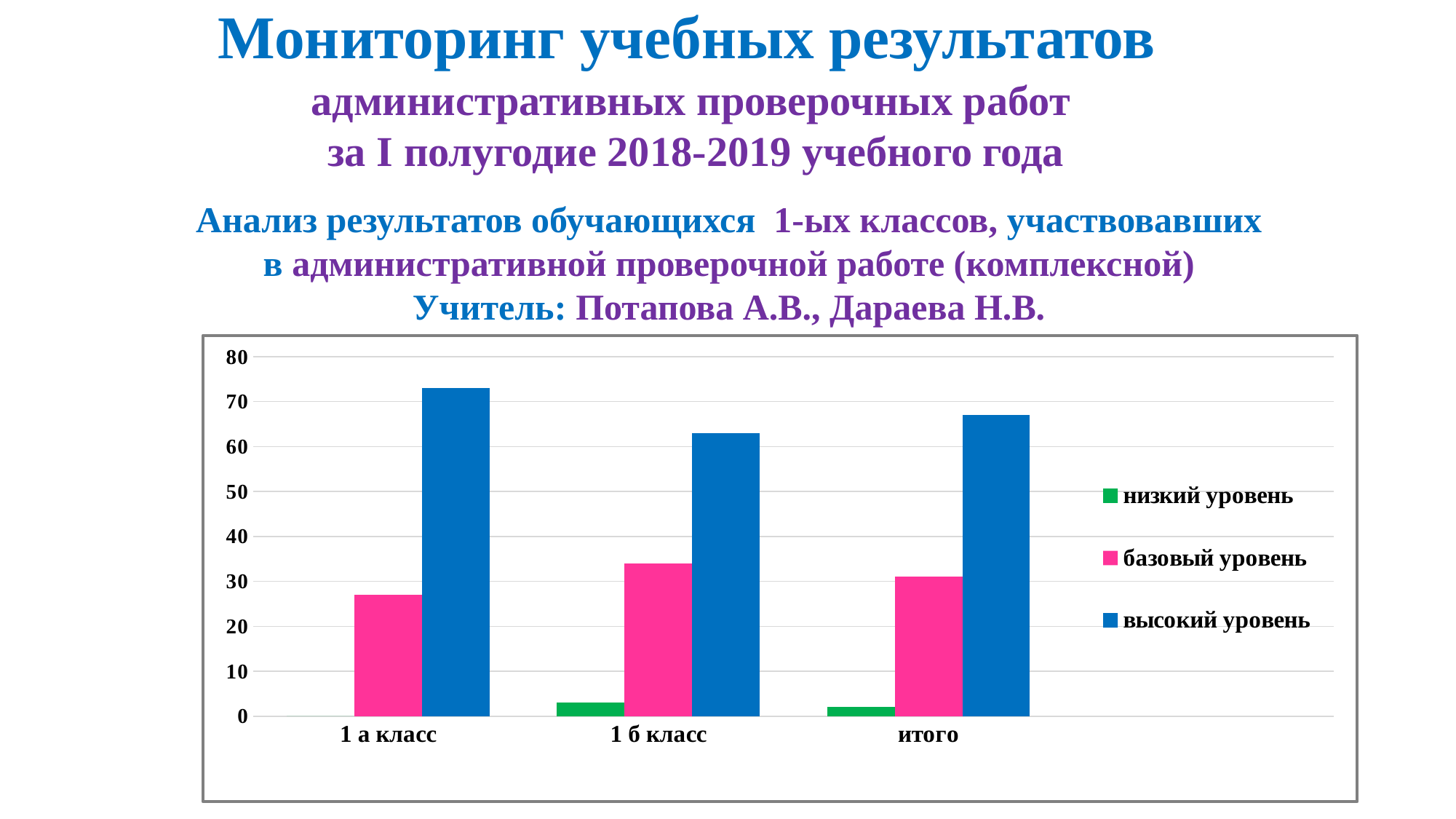
What kind of chart is shown on the slide? bar chart Which is larger: базовый уровень for 1 а класс or базовый уровень for 1 б класс? 1 б класс Is the value of высокий уровень for 1 а класс greater or less than 70? greater How many series does the chart legend list? 3 Is the value of низкий уровень for 1 б класс greater or less than 10? less Which colour represents высокий уровень in the chart? blue Which category has the highest value for высокий уровень? 1 а класс Is the value of высокий уровень for итого greater or less than 60? greater How many categories are shown on the x axis of the chart? 3 Which is larger: высокий уровень for 1 а класс or высокий уровень for 1 б класс? 1 а класс